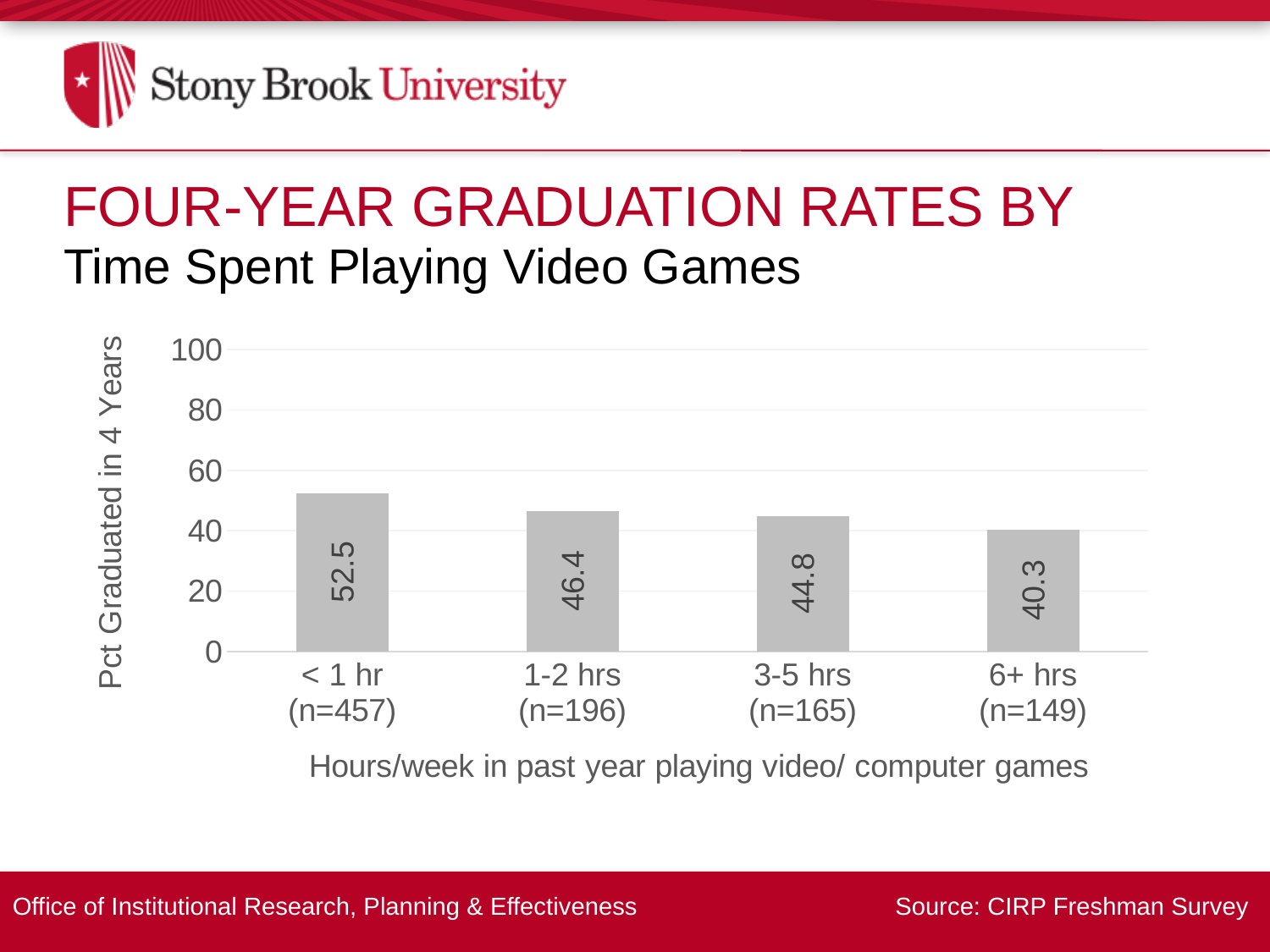
Which category has the lowest four-year graduation rate? 6+ hrs Which has a higher graduation rate, the 1-2 hrs category or the 3-5 hrs category? 1-2 hrs What is the four-year graduation rate for the 1-2 hrs category? 46.4 Is the graduation rate for the 6+ hrs category greater or less than 60? less What is the four-year graduation rate for students who played 6+ hours per week? 40.3 What type of chart is shown on the slide? Bar chart Do the graduation rates rise or fall as hours spent playing video games increase? Fall What is the four-year graduation rate for students who played video games less than 1 hour per week? 52.5 What is the four-year graduation rate for the 3-5 hrs category? 44.8 What is the difference in graduation rate between the < 1 hr and 6+ hrs categories? 12.2 How many categories of video game hours are shown in the chart? 4 Which category has the highest four-year graduation rate? < 1 hr